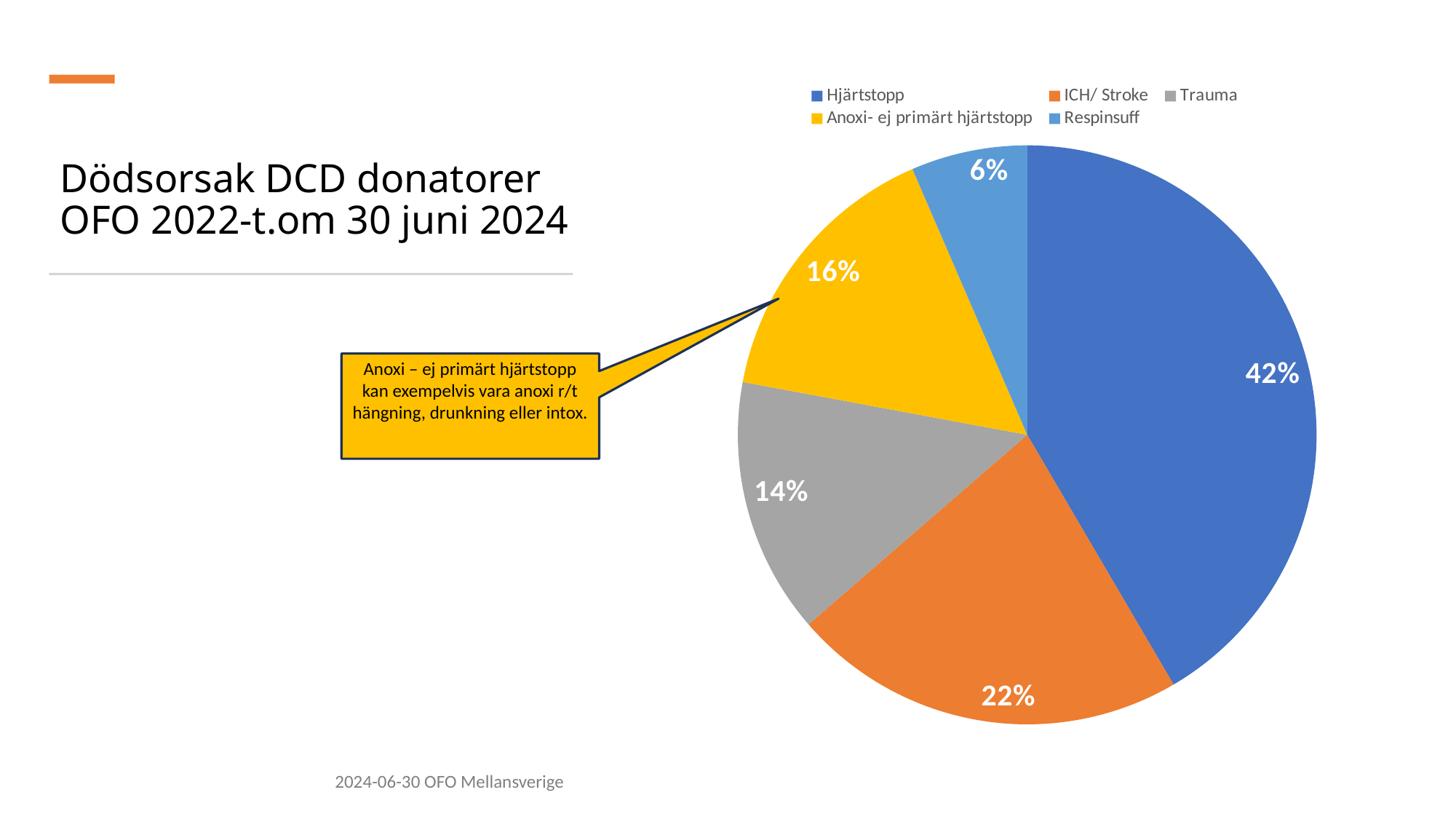
What kind of chart is shown on the slide? pie chart What is the value shown for ICH/ Stroke? 22% What is the value shown for Respinsuff? 6% Which category has the largest slice of the pie? Hjärtstopp What is the value shown for Trauma? 14% Which is larger, the share for Anoxi- ej primärt hjärtstopp or the share for Trauma? Anoxi- ej primärt hjärtstopp Which category has the smallest slice of the pie? Respinsuff What share of the pie does Hjärtstopp account for? 42% How many categories does the pie chart have? 5 Which colour represents Trauma in the pie chart? grey What is the value shown for Anoxi- ej primärt hjärtstopp? 16% What is the difference between the Hjärtstopp and ICH/ Stroke shares? 20%